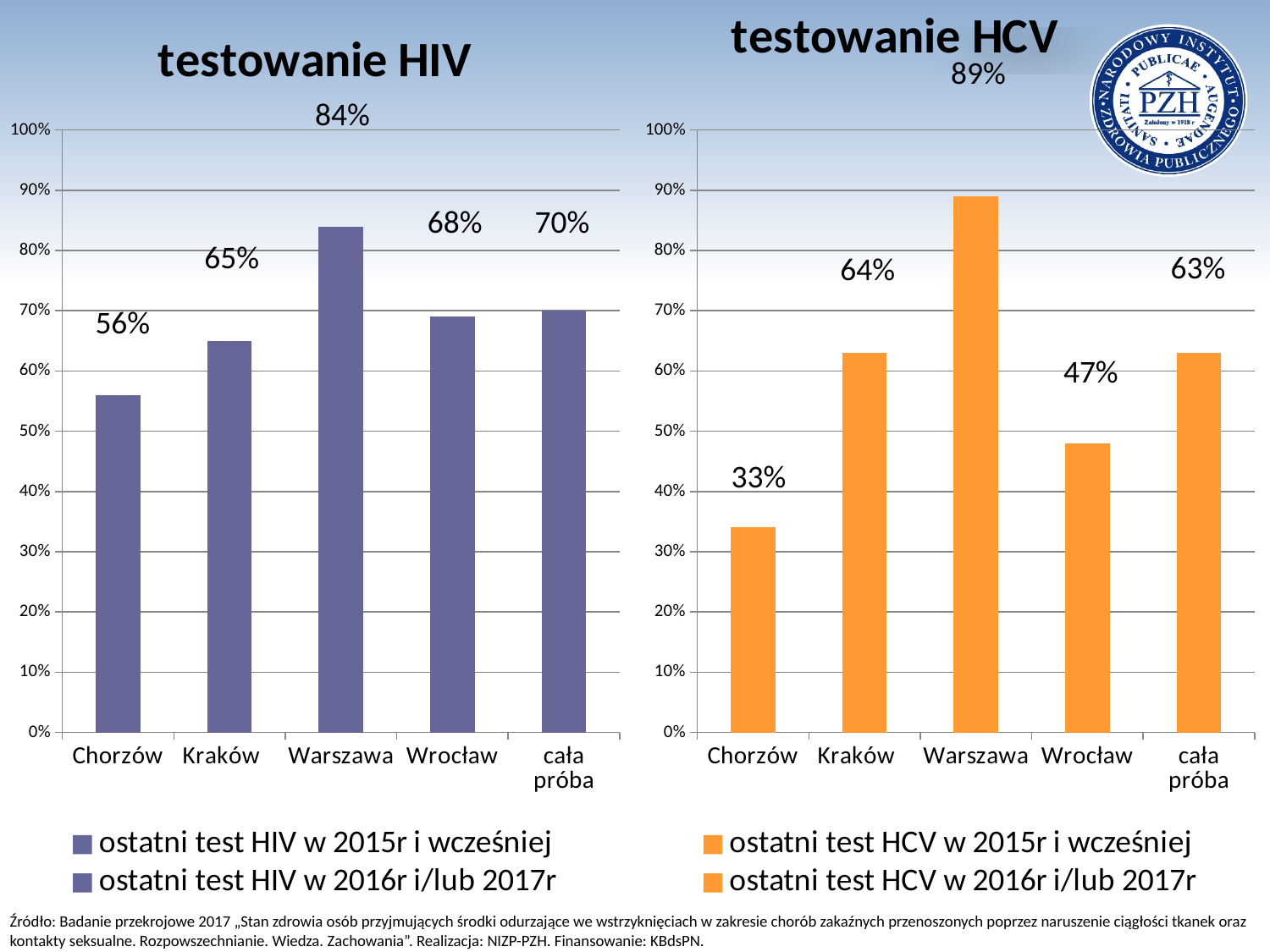
In the 'testowanie HIV' chart, what is the difference between the values for Warszawa and Chorzów? 28% In the 'testowanie HIV' chart, which category has the highest value? Warszawa In the 'testowanie HCV' chart, what is the difference between the values for Kraków and Wrocław? 17% In the 'testowanie HIV' chart, what is the value for Chorzów? 56% In the 'testowanie HCV' chart, what is the value for cała próba? 63% In the 'testowanie HIV' chart, what is the value for Warszawa? 84% What kind of chart is the 'testowanie HCV' chart? bar chart In the 'testowanie HCV' chart, what is the value for Wrocław? 47% In the 'testowanie HCV' chart, which category has the lowest value? Chorzów Which is larger: the value for Kraków in the 'testowanie HIV' chart or the value for Kraków in the 'testowanie HCV' chart? testowanie HIV In the 'testowanie HCV' chart, is the value for Warszawa greater or less than 80%? greater How many categories are shown on the x axis of the 'testowanie HIV' chart? 5